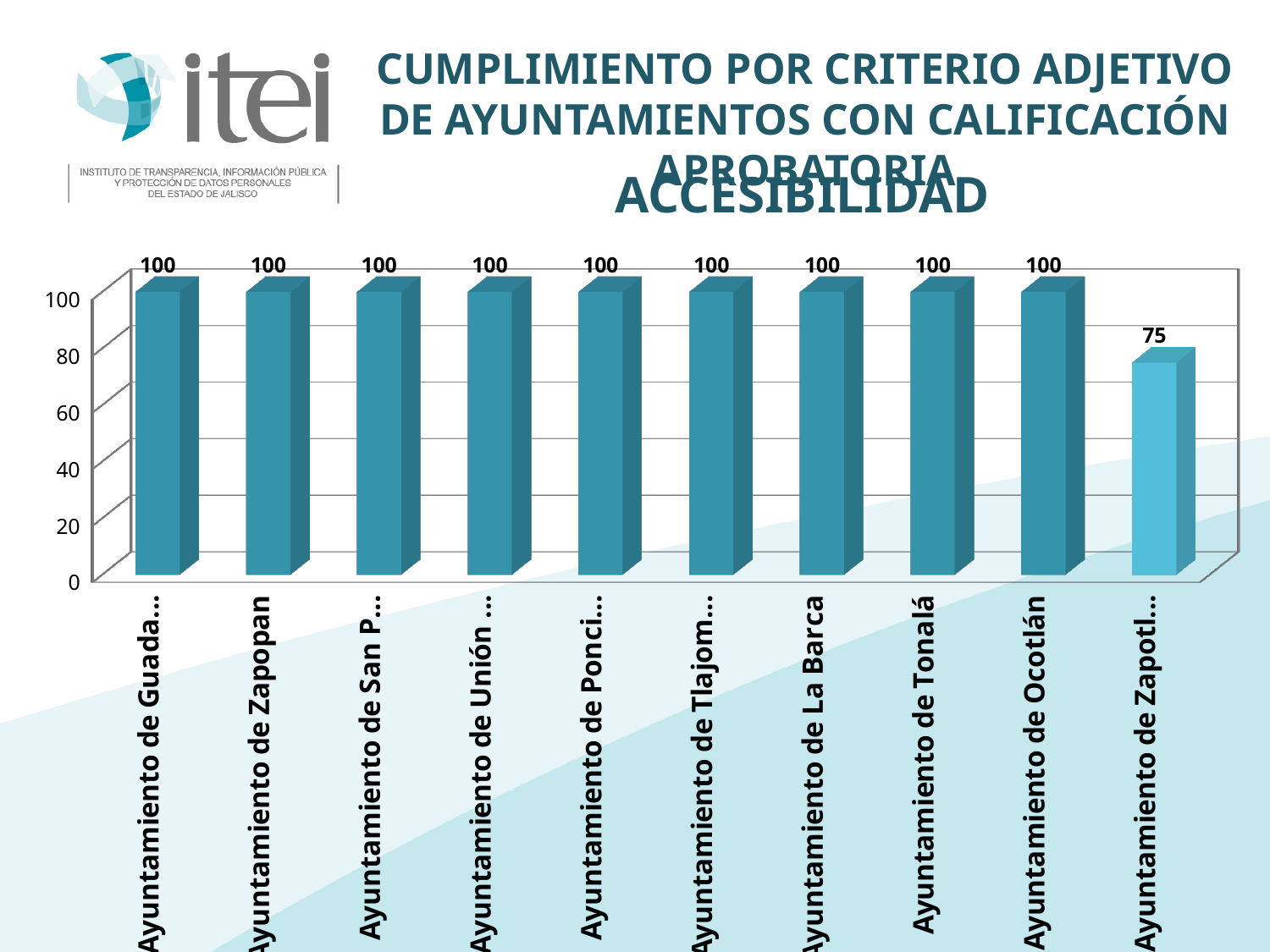
What is the title of the chart? ACCESIBILIDAD What is the value of the rightmost bar in the chart? 75 What is the value for Ayuntamiento de Ocotlán? 100 Which bar has the lowest value in the chart? The rightmost bar (Ayuntamiento de Zapotl...) What is the value for Ayuntamiento de Tonalá? 100 What kind of chart is shown on the slide? Bar chart What is the difference between the value for Ayuntamiento de Zapopan and the value of the rightmost bar? 25 Which is larger: the value for Ayuntamiento de Tonalá or the value of the rightmost bar? Ayuntamiento de Tonalá What is the value for Ayuntamiento de La Barca? 100 Is the value of the rightmost bar greater or less than 80? less What is the value for Ayuntamiento de Zapopan? 100 How many bars are shown in the chart? 10